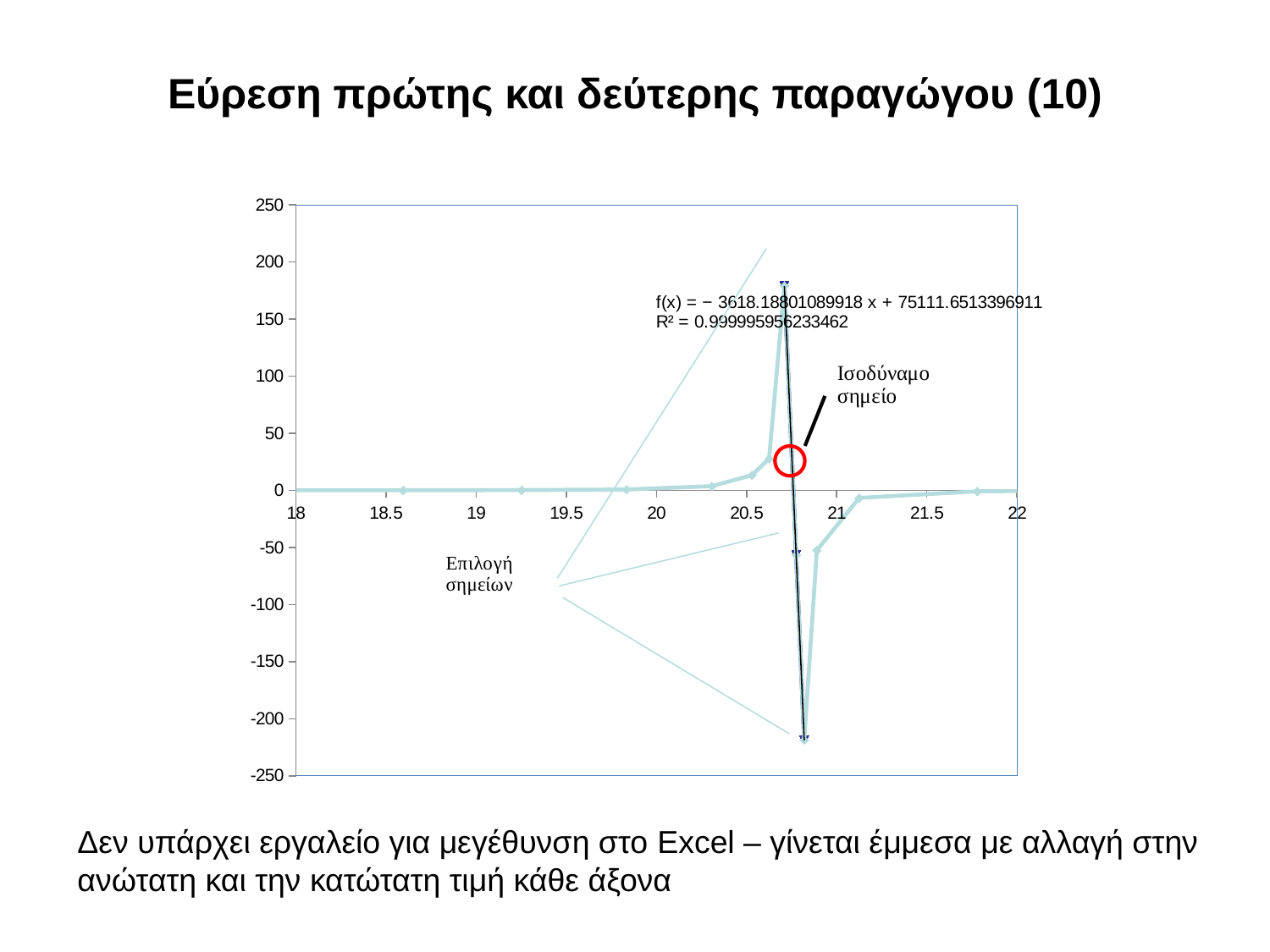
Do the plotted values rise or fall as x goes from 18 to 20.5? rise Is the plotted value at x = 19 greater or less than 50? less What is the slope of the fitted line f(x) printed on the chart? −3618.18801089918 Which is larger: the plotted value at x = 18.5 or the peak value near x = 20.7? the peak value near x = 20.7 What is the R² value printed on the chart? 0.999995956233462 What kind of chart is shown on the slide? line chart Do the plotted values rise or fall as x goes from the peak near 20.7 to the trough near 20.8? fall Is the highest point of the plotted curve greater or less than 150? greater Is the plotted value at x = 21.5 greater or less than -50? greater What is the maximum value shown on the y axis? 250